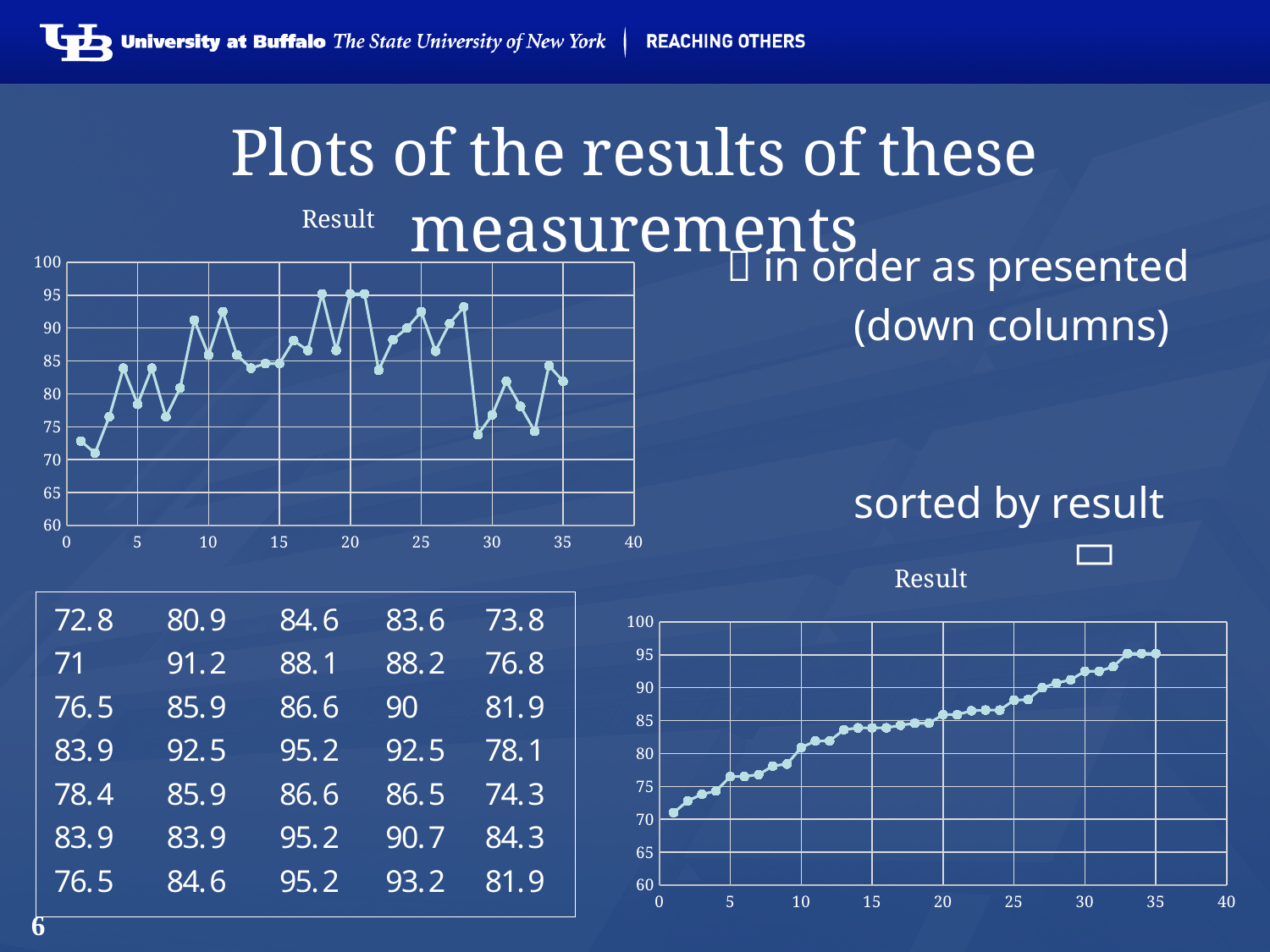
What type of chart is the bottom-right chart titled "Result"? line chart In the bottom-right chart (sorted by result), which is larger: the value at x = 35 or the value at x = 1? x = 35 What type of chart is the top-left chart titled "Result"? line chart In the bottom-right chart (sorted by result), is the value at x = 35 greater or less than 90? greater In the bottom-right chart (sorted by result), is the value at x = 1 greater or less than 75? less In the top-left chart (in order as presented), is the value at x = 20 greater or less than 90? greater In the top-left chart (in order as presented), which is larger: the value at x = 20 or the value at x = 2? x = 20 What is the highest value shown on the y axis of the top-left chart? 100 In the bottom-right chart (sorted by result), do the values rise or fall along the x axis? rise How many data points are plotted in the bottom-right chart (sorted by result)? 35